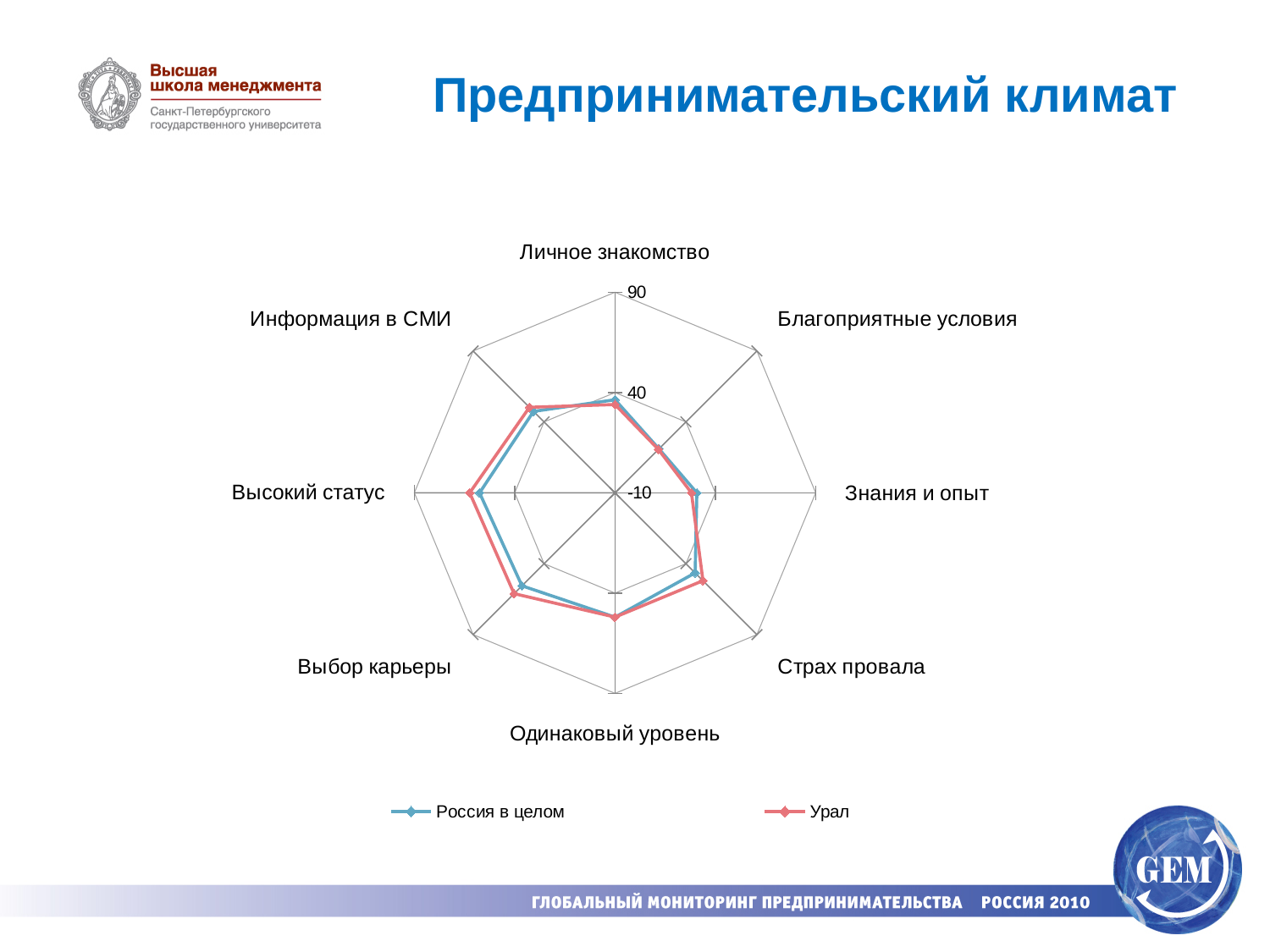
How many series does the legend list? 2 For Высокий статус, which series has the larger value, Россия в целом or Урал? Урал Is the value for Высокий статус for Урал greater or less than 40? greater Is the value for Выбор карьеры for Россия в целом greater or less than 40? greater What are the two series named in the legend? Россия в целом and Урал How many categories (axes) does the radar chart have? 8 Which category has the lowest value for the Россия в целом series? Благоприятные условия Which category has the lowest value for the Урал series? Благоприятные условия What kind of chart is shown on the slide? Radar chart Is the value for Благоприятные условия for Урал greater or less than 40? less What is the title of the slide containing the chart? Предпринимательский климат